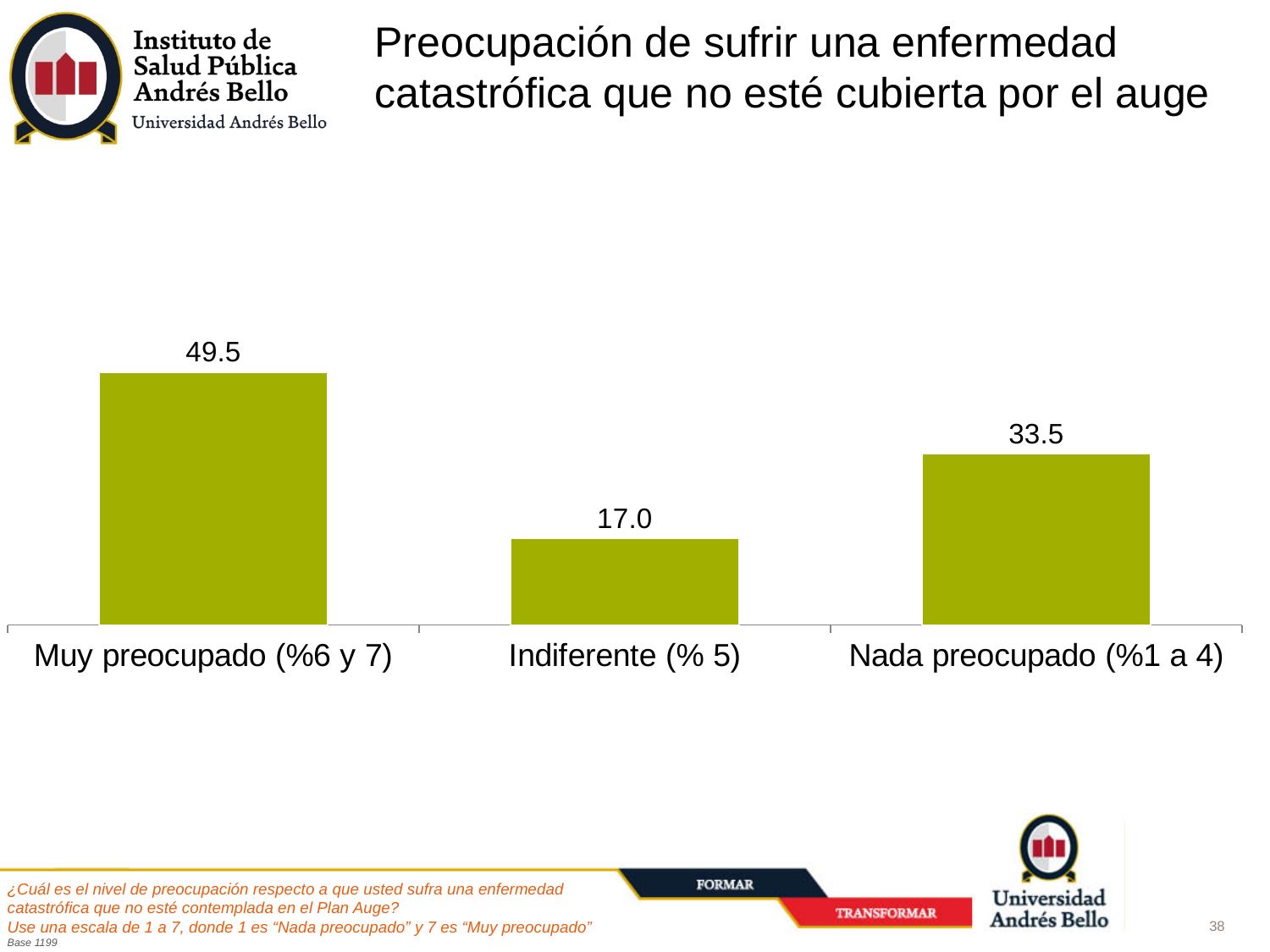
What is the value for "Indiferente (% 5)"? 17.0 What is the difference between the values for "Muy preocupado (%6 y 7)" and "Nada preocupado (%1 a 4)"? 16.0 What colour are the bars in the chart? Green Which is larger, the value for "Indiferente (% 5)" or the value for "Nada preocupado (%1 a 4)"? Nada preocupado (%1 a 4) Which category has the lowest value? Indiferente (% 5) What is the total of the three values shown in the chart? 100.0 Which category has the highest value? Muy preocupado (%6 y 7) What is the difference between the values for "Nada preocupado (%1 a 4)" and "Indiferente (% 5)"? 16.5 What is the value for "Nada preocupado (%1 a 4)"? 33.5 How many categories are shown in the chart? 3 What is the value for "Muy preocupado (%6 y 7)"? 49.5 What kind of chart is shown on the slide? Bar chart